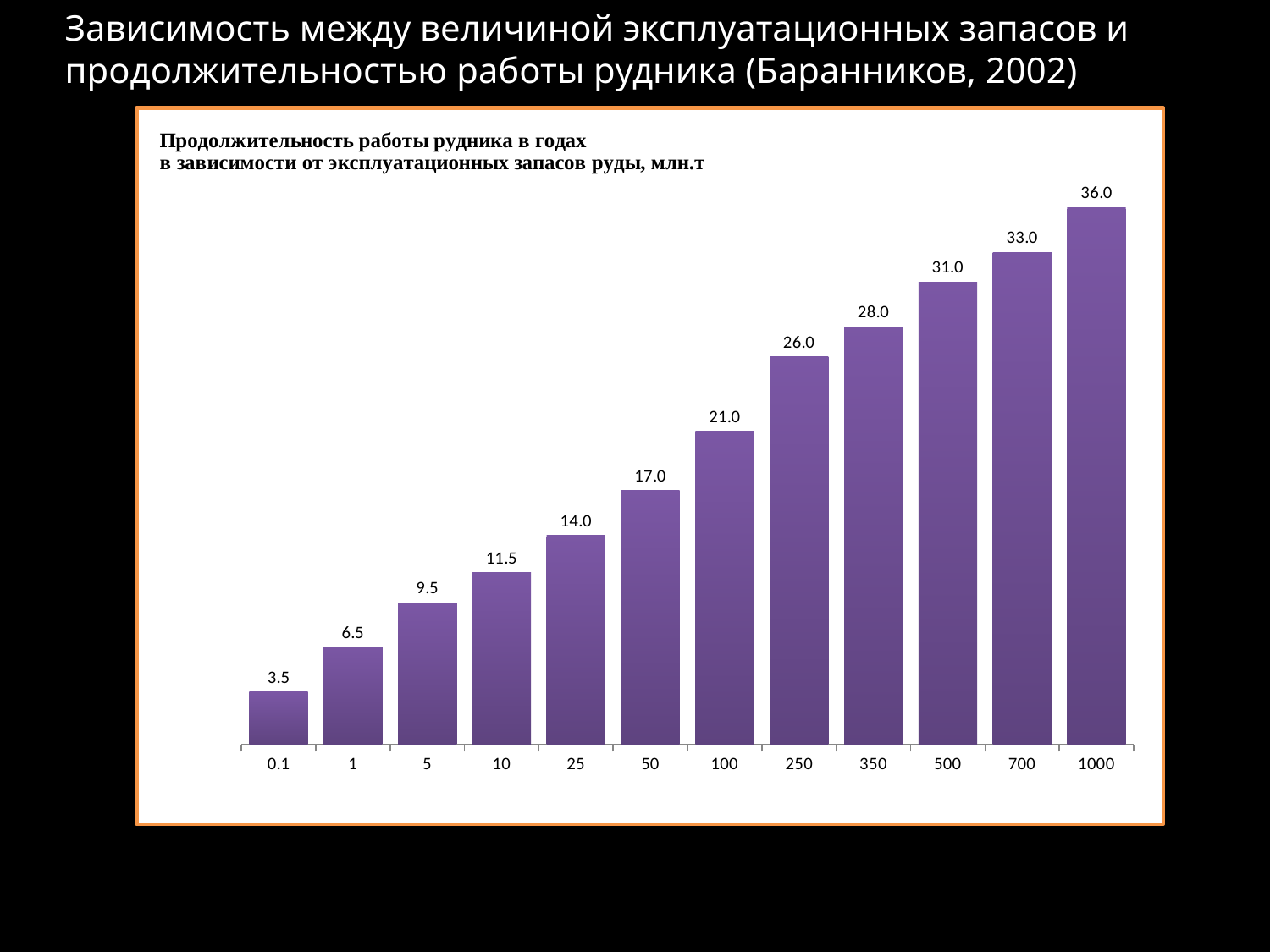
What is the difference between the values for 100 and 50? 4.0 What is the difference between the values for 1000 and 700? 3.0 Which is larger, the value for 250 or the value for 350? 350 What is the mine operating life in years for ore reserves of 25 million tonnes? 14.0 What kind of chart is this? bar chart What colour are the bars? purple Which category has the lowest value? 0.1 What value is shown for the 500 category? 31.0 Do the values rise or fall from left to right along the x axis? rise Which category has the highest value? 1000 What is the value for the 0.1 category? 3.5 How many categories are shown on the x axis? 12